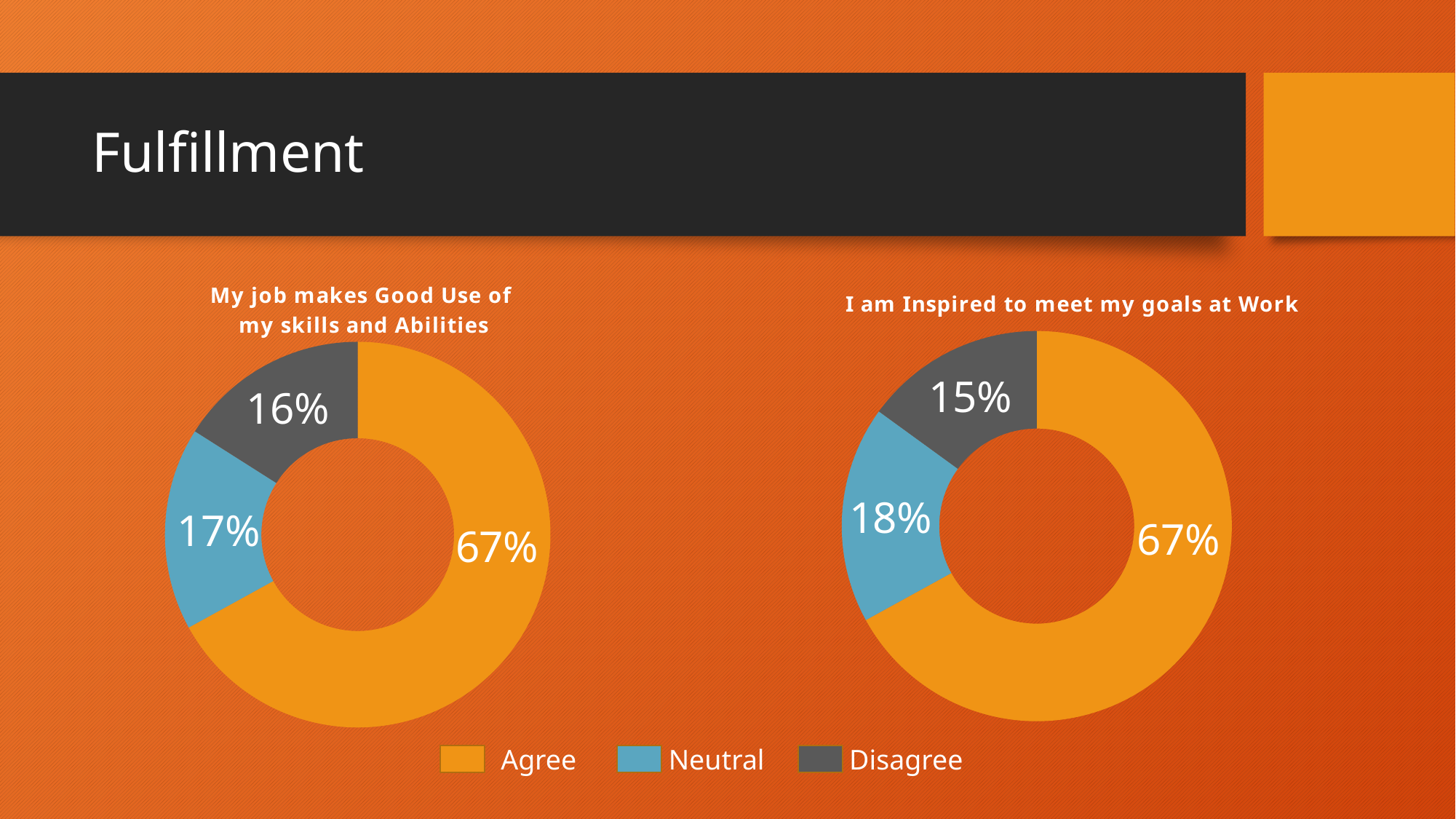
In the chart titled "My job makes Good Use of my skills and Abilities", what percentage of respondents Agree? 67% What kind of chart is the chart titled "I am Inspired to meet my goals at Work"? Doughnut chart In the chart titled "I am Inspired to meet my goals at Work", what percentage of respondents are Neutral? 18% In the chart titled "My job makes Good Use of my skills and Abilities", what percentage of respondents are Neutral? 17% In the legend, which colour represents Neutral? Blue In the chart titled "My job makes Good Use of my skills and Abilities", which response has the smallest share? Disagree In the chart titled "My job makes Good Use of my skills and Abilities", what percentage of respondents Disagree? 16% How many categories does the legend list for the charts on this slide? 3 Which chart has the larger Disagree share: "My job makes Good Use of my skills and Abilities" or "I am Inspired to meet my goals at Work"? My job makes Good Use of my skills and Abilities In the chart titled "I am Inspired to meet my goals at Work", which response has the largest share? Agree In the chart titled "I am Inspired to meet my goals at Work", what percentage of respondents Disagree? 15% In the chart titled "I am Inspired to meet my goals at Work", what is the difference between the Agree and Neutral percentages? 49%